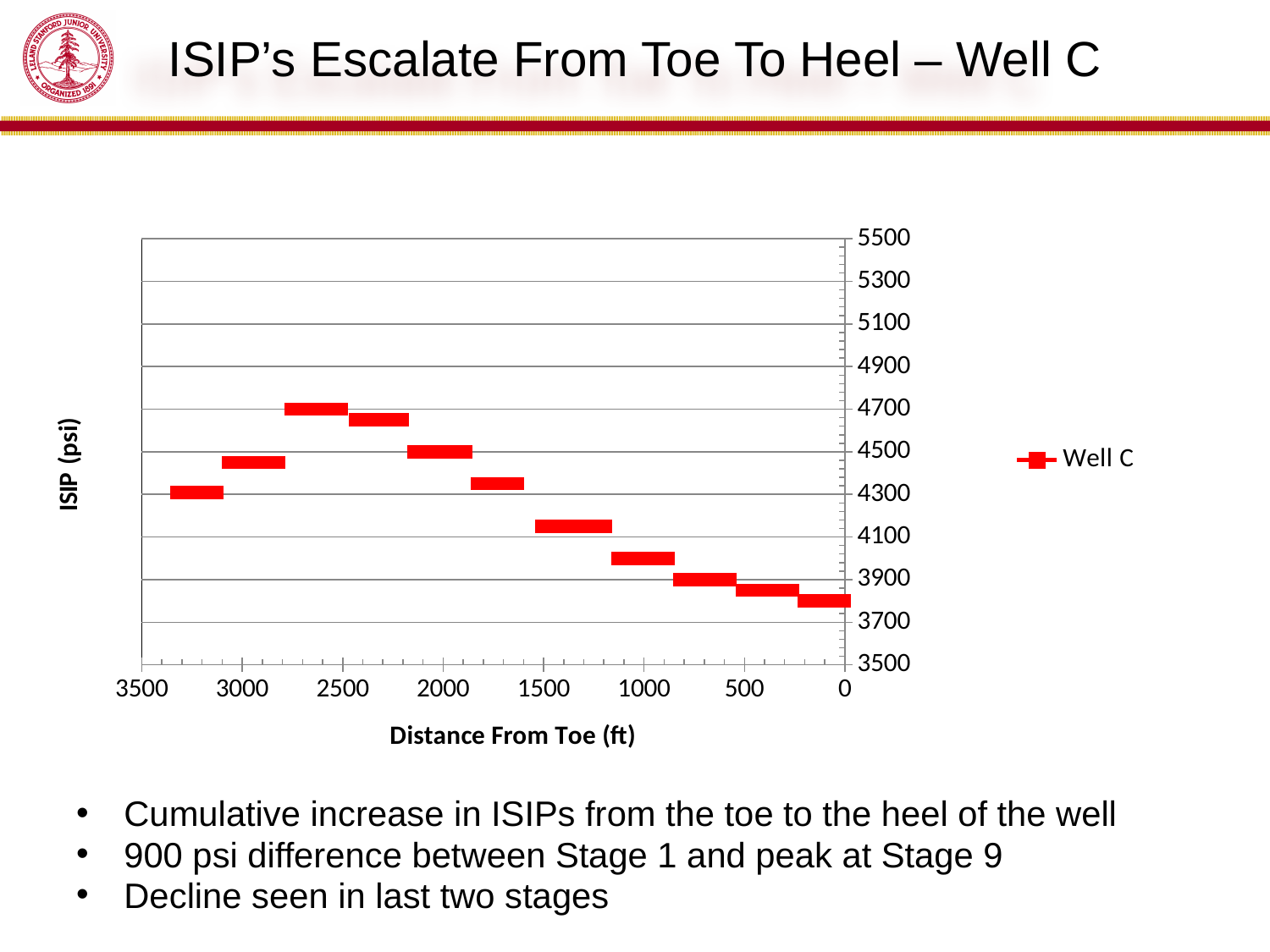
What is the title of the x axis? Distance From Toe (ft) Is the ISIP value for the point near 1000 ft from the toe greater or less than 4100? less Which is larger: the ISIP value near 2600 ft from the toe or the ISIP value near 0 ft from the toe? near 2600 ft from the toe Is the ISIP value for the highest point (near 2600 ft from the toe) greater or less than 4500? greater Is the ISIP value for the point nearest 0 ft from the toe greater or less than 3900? less How many series does the legend list? 1 Which point has the lowest ISIP value? the point nearest 0 ft from the toe What is the highest value shown on the y axis? 5500 What is the name of the series shown in the legend? Well C How many data points are plotted for Well C? 11 Do the ISIP values rise or fall moving from the peak near 2600 ft toward 0 ft from the toe? fall